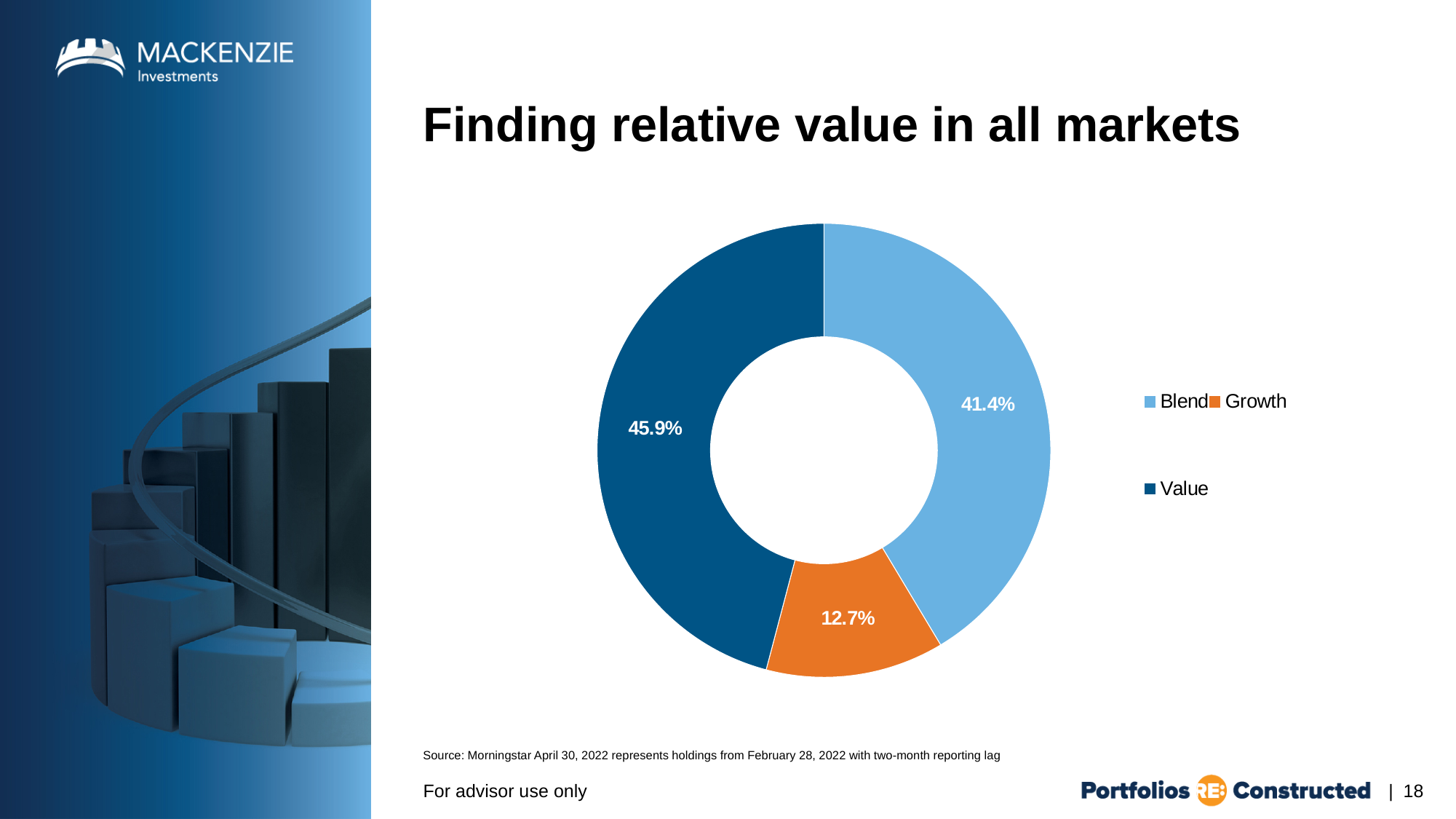
Which category has the smallest share of the chart? Growth What is the difference in percentage points between the Value and Blend shares? 4.5 What is the difference in percentage points between the Blend and Growth shares? 28.7 Which category has the largest share of the chart? Value What colour is the Growth slice? Orange How many categories does the chart show? 3 What kind of chart is shown on the slide? Doughnut (pie) chart What is the title of the slide containing the chart? Finding relative value in all markets What share of the chart is Value? 45.9% What share of the chart is Blend? 41.4% Which is larger, the Blend share or the Growth share? Blend What share of the chart is Growth? 12.7%